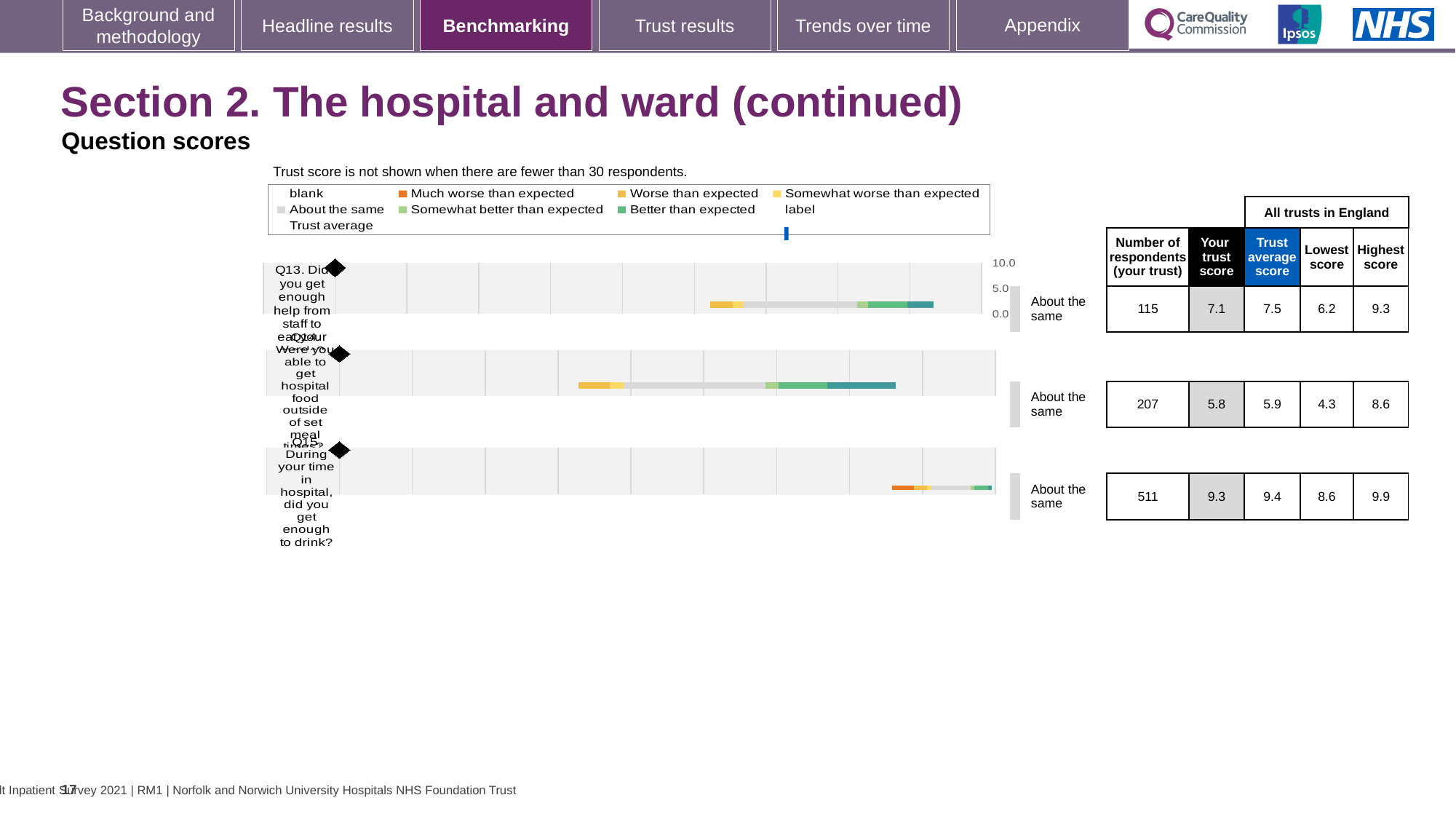
What is the highest score across all trusts in England for Q15 (did you get enough to drink?)? 9.9 Which question has the highest 'Your trust score'? Q15 Which question has the lowest 'Your trust score'? Q14 What kind of chart is used to show the question scores on this slide? bar chart What is the lowest score across all trusts in England for Q14? 4.3 How many respondents (your trust) are shown for Q14 (Were you able to get hospital food outside of set meal times?)? 207 What is the maximum value shown on the chart's score axis? 10.0 How many questions (categories) are plotted in the chart? 3 For Q14, which is larger: your trust score or the trust average score? Trust average score What benchmark category is shown next to the bar for Q13? About the same For Q13, what is the difference between the trust average score and your trust score? 0.4 What is the 'Your trust score' value for Q13 (Did you get enough help from staff to eat your meals?)? 7.1